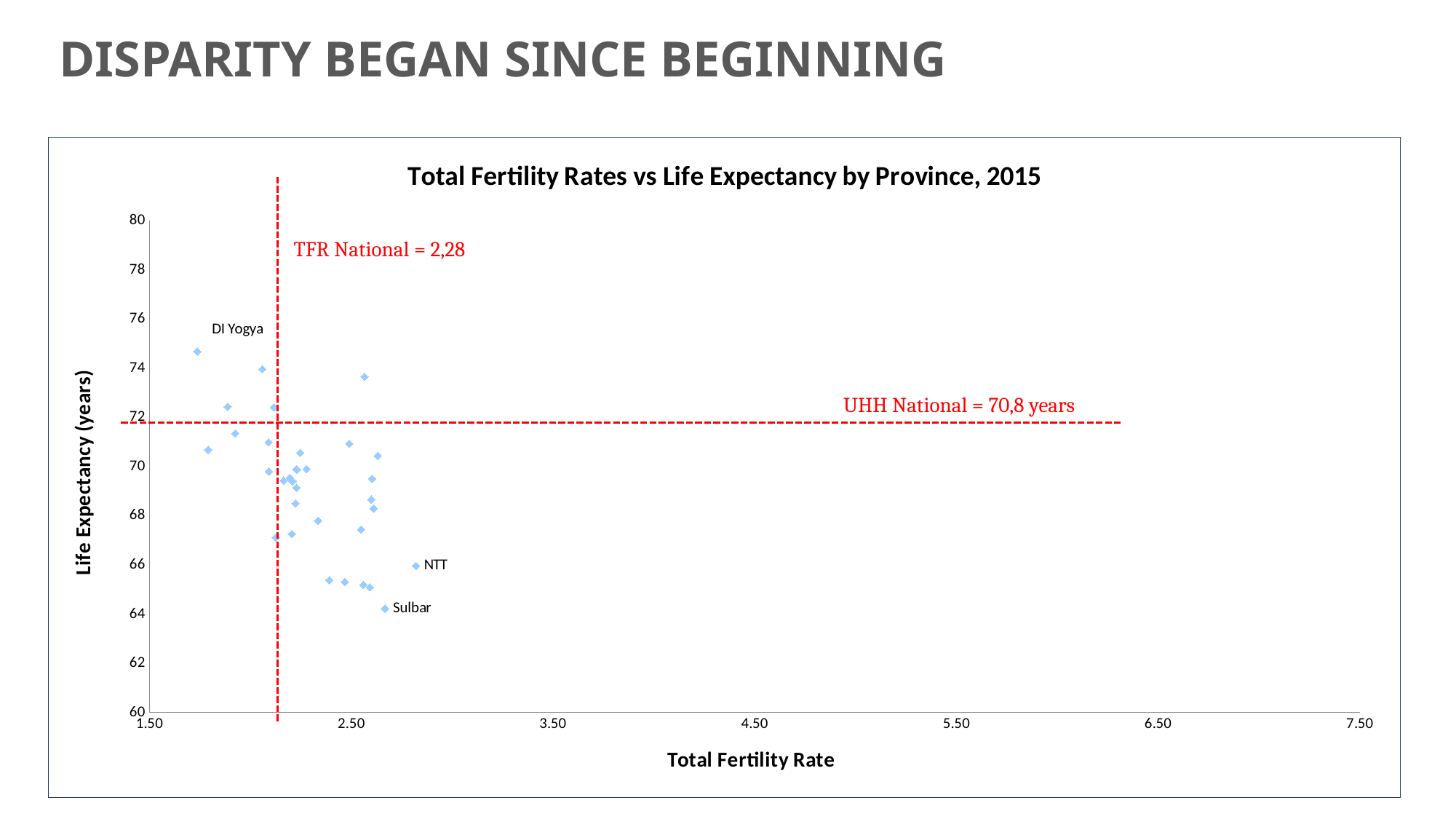
Which has the higher life expectancy, DI Yogya or Sulbar? DI Yogya What is the title of the chart? Total Fertility Rates vs Life Expectancy by Province, 2015 Is the life expectancy for Sulbar greater or less than 66? less What national TFR value is marked by the vertical dashed line on the chart? 2,28 Which has the higher life expectancy, NTT or Sulbar? NTT What kind of chart is shown on the slide? scatter chart Is the total fertility rate for NTT greater or less than 2.50? greater Which labelled province has the lowest life expectancy on the chart? Sulbar What is the label of the vertical axis of the chart? Life Expectancy (years) What national UHH value is marked by the horizontal dashed line on the chart? 70,8 years Is the total fertility rate for DI Yogya greater or less than 2.50? less